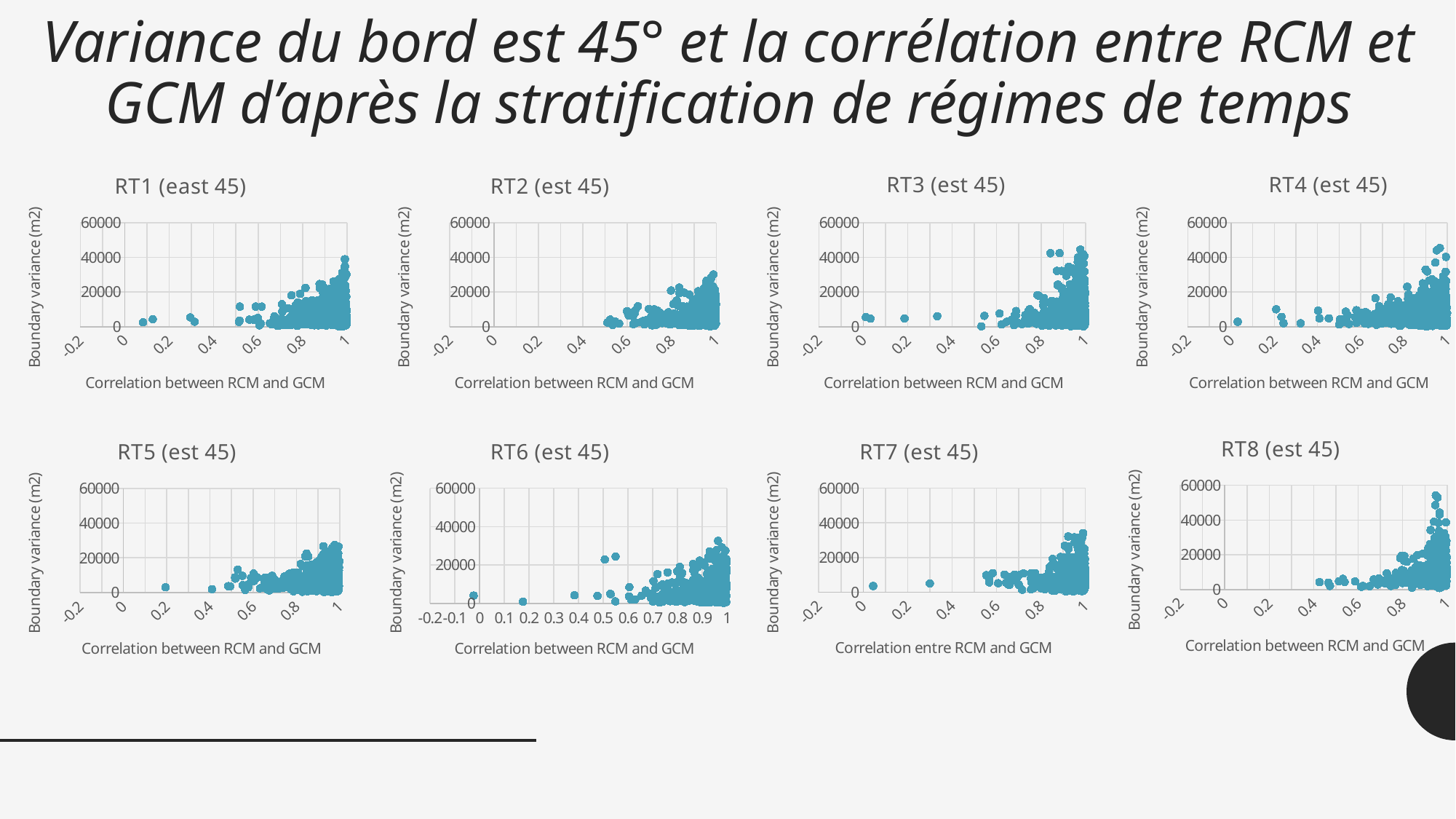
In the RT8 (est 45) chart, is the highest boundary variance point greater or less than 40000? greater In the RT2 (est 45) chart, is the highest boundary variance point greater or less than 40000? less What is the y-axis label of the RT1 (east 45) chart? Boundary variance (m2) In the RT8 (est 45) chart, does boundary variance tend to rise or fall as the correlation between RCM and GCM increases toward 1? rise In the RT7 (est 45) chart, is the highest boundary variance point greater or less than 40000? less In the RT3 (est 45) chart, does boundary variance tend to rise or fall as the correlation increases along the x axis? rise Which of the eight charts contains the single highest boundary variance point? RT8 (est 45) How many charts are shown on the slide? 8 What is the highest tick value shown on the y axis of the RT4 (est 45) chart? 60000 Which chart has a higher maximum boundary variance point, RT8 (est 45) or RT5 (est 45)? RT8 (est 45) What kind of chart is RT1 (east 45)? scatter chart